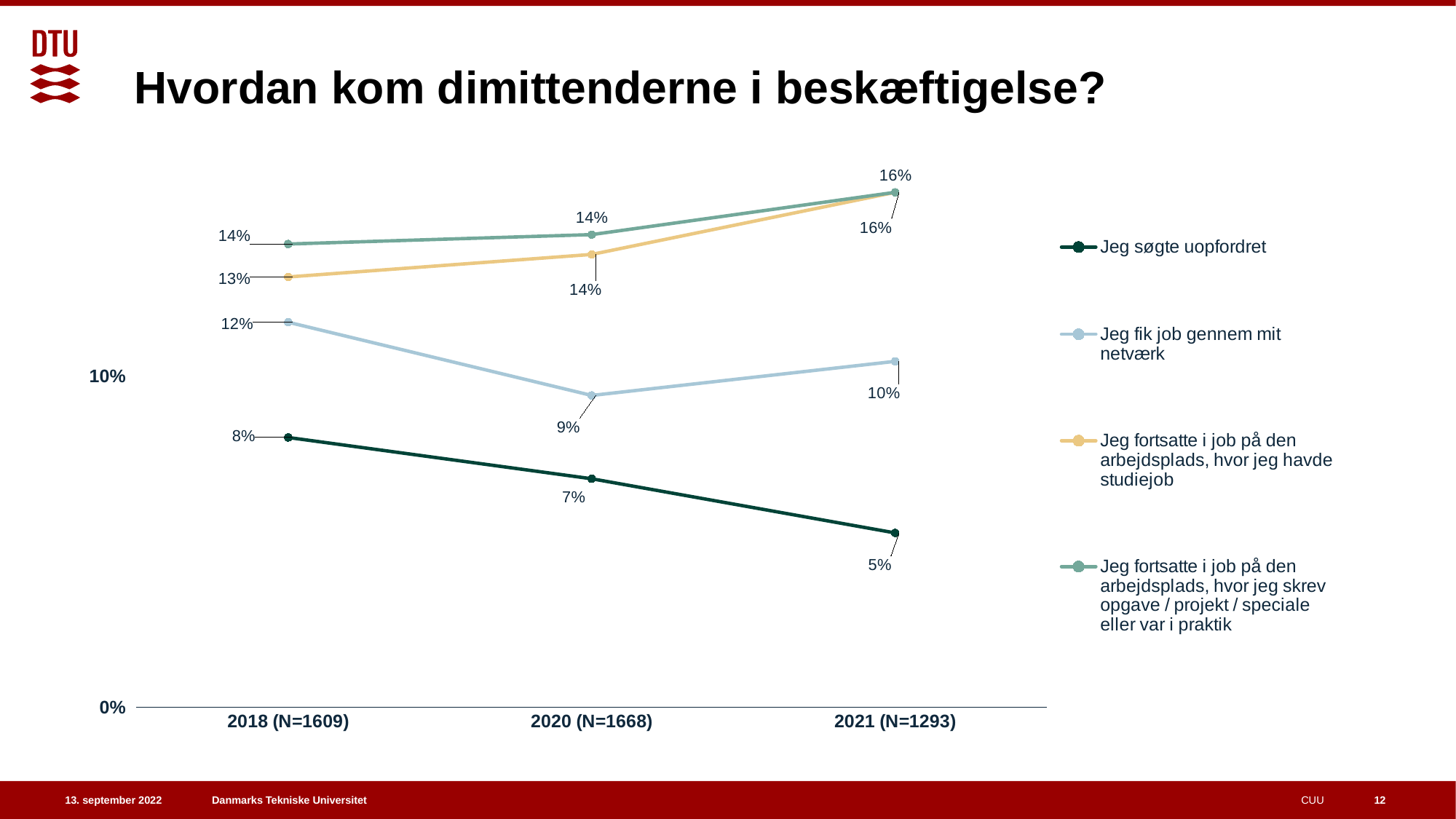
Is the value for 'Jeg fik job gennem mit netværk' in 2018 (N=1609) greater or less than 10%? greater Which is larger in 2020 (N=1668): 'Jeg fik job gennem mit netværk' or 'Jeg søgte uopfordret'? Jeg fik job gennem mit netværk How many series does the legend list? 4 What is the value for 'Jeg fortsatte i job på den arbejdsplads, hvor jeg havde studiejob' in 2018 (N=1609)? 13% Which series has the highest value in 2018 (N=1609)? Jeg fortsatte i job på den arbejdsplads, hvor jeg skrev opgave / projekt / speciale eller var i praktik Which series has the lowest value in 2021 (N=1293)? Jeg søgte uopfordret How many points along the x axis does the chart have? 3 What is the difference between the 2018 and 2021 values for 'Jeg søgte uopfordret'? 3% What is the value for 'Jeg søgte uopfordret' in 2021 (N=1293)? 5% What is the value for 'Jeg fik job gennem mit netværk' in 2020 (N=1668)? 9% Does the value for 'Jeg søgte uopfordret' rise or fall from 2018 to 2021? fall What kind of chart is shown on the slide? line chart